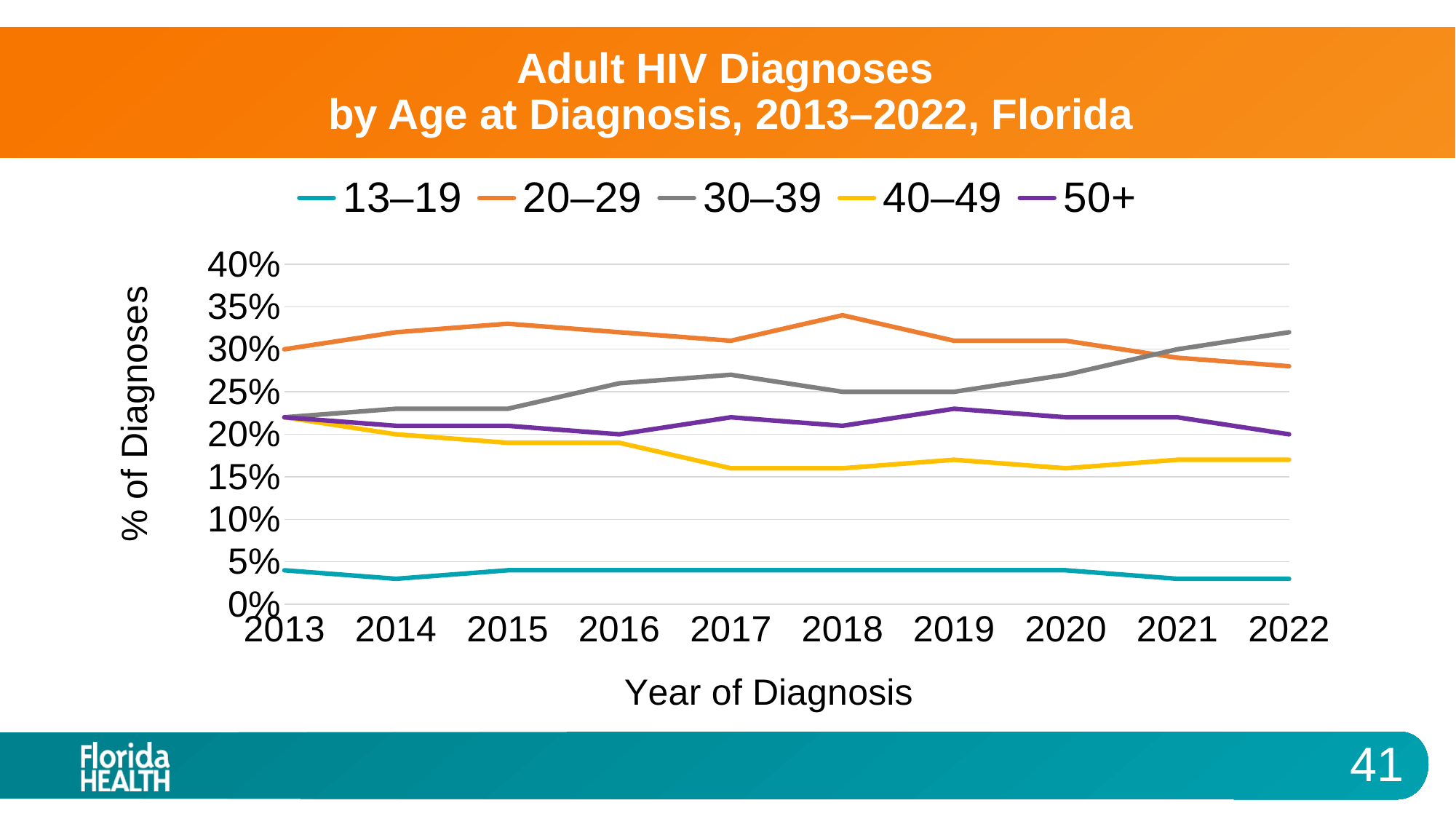
What is the title of the chart? Adult HIV Diagnoses by Age at Diagnosis, 2013–2022, Florida How many years are shown on the x axis? 10 Which age group has the highest percentage of diagnoses in 2022? 30–39 What type of chart is shown on the slide? line chart In 2022, which is larger: the value for the 50+ group or the value for the 40–49 group? 50+ Is the value for the 40–49 group in 2017 greater or less than 20%? less What is the label of the y axis? % of Diagnoses Which age group has the highest percentage of diagnoses in 2018? 20–29 Which age group has the lowest percentage of diagnoses in every year shown? 13–19 Is the value for the 20–29 group in 2018 greater or less than 30%? greater How many series does the legend list? 5 Does the 30–39 line rise or fall from 2019 to 2022? rise